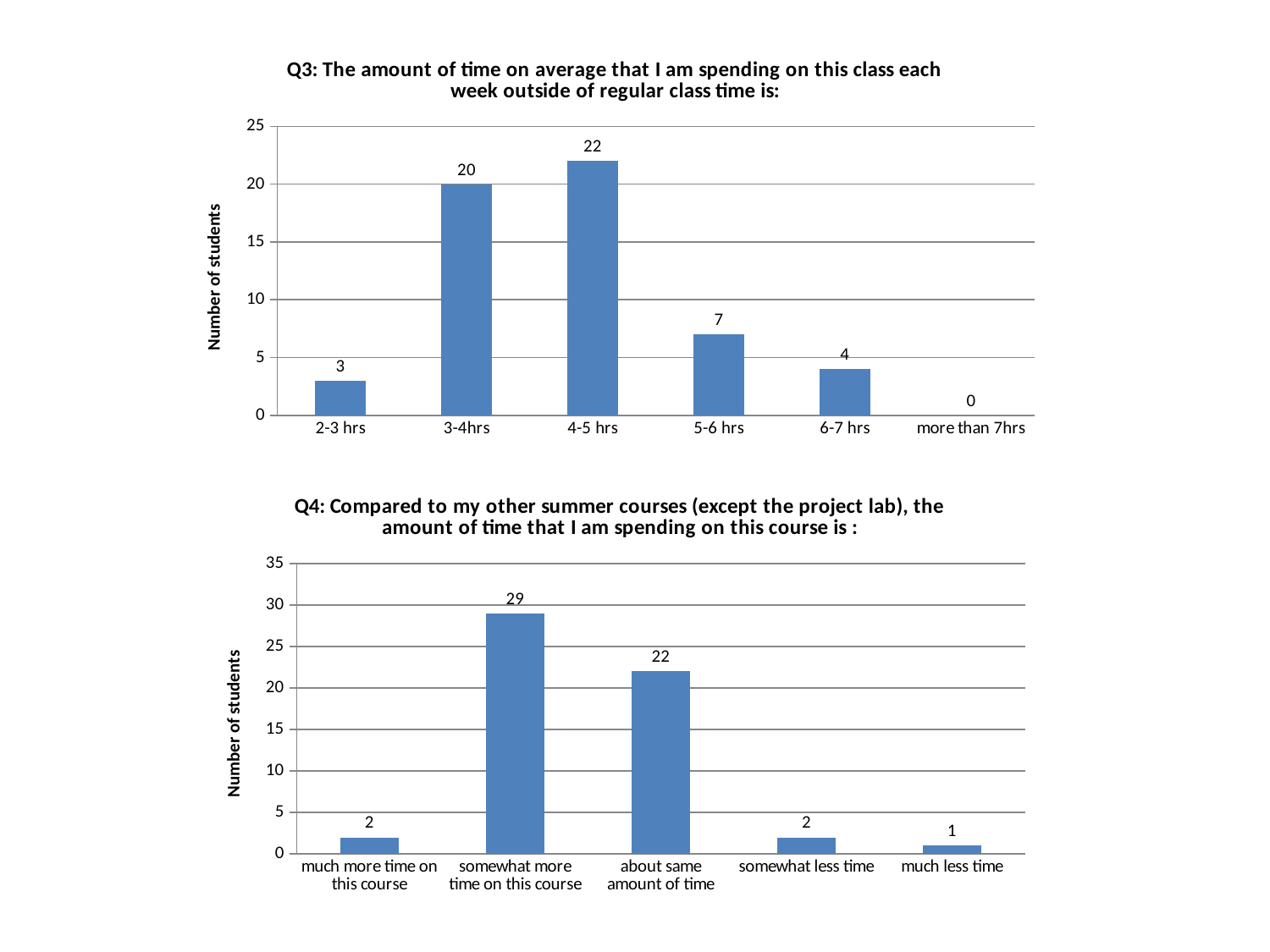
In the Q3 chart (top), which category has the lowest number of students? more than 7hrs What type of chart is the Q4 chart (bottom)? bar chart In the Q3 chart (top), what is the difference between the number of students for 3-4hrs and 5-6 hrs? 13 In the Q4 chart (bottom), which category has the lowest number of students? much less time In the Q4 chart (bottom), which is larger: the value for 'somewhat more time on this course' or 'about same amount of time'? somewhat more time on this course In the Q4 chart (bottom), how many categories are shown on the x axis? 5 In the Q3 chart (top), how many categories are shown on the x axis? 6 In the Q4 chart (bottom), how many students said they spend somewhat more time on this course? 29 In the Q4 chart (bottom), what is the difference between the values for 'somewhat more time on this course' and 'about same amount of time'? 7 In the Q3 chart (top), what is the y-axis label? Number of students In the Q3 chart (top), how many students reported spending 4-5 hrs per week outside of class? 22 In the Q3 chart (top), which category has the highest number of students? 4-5 hrs